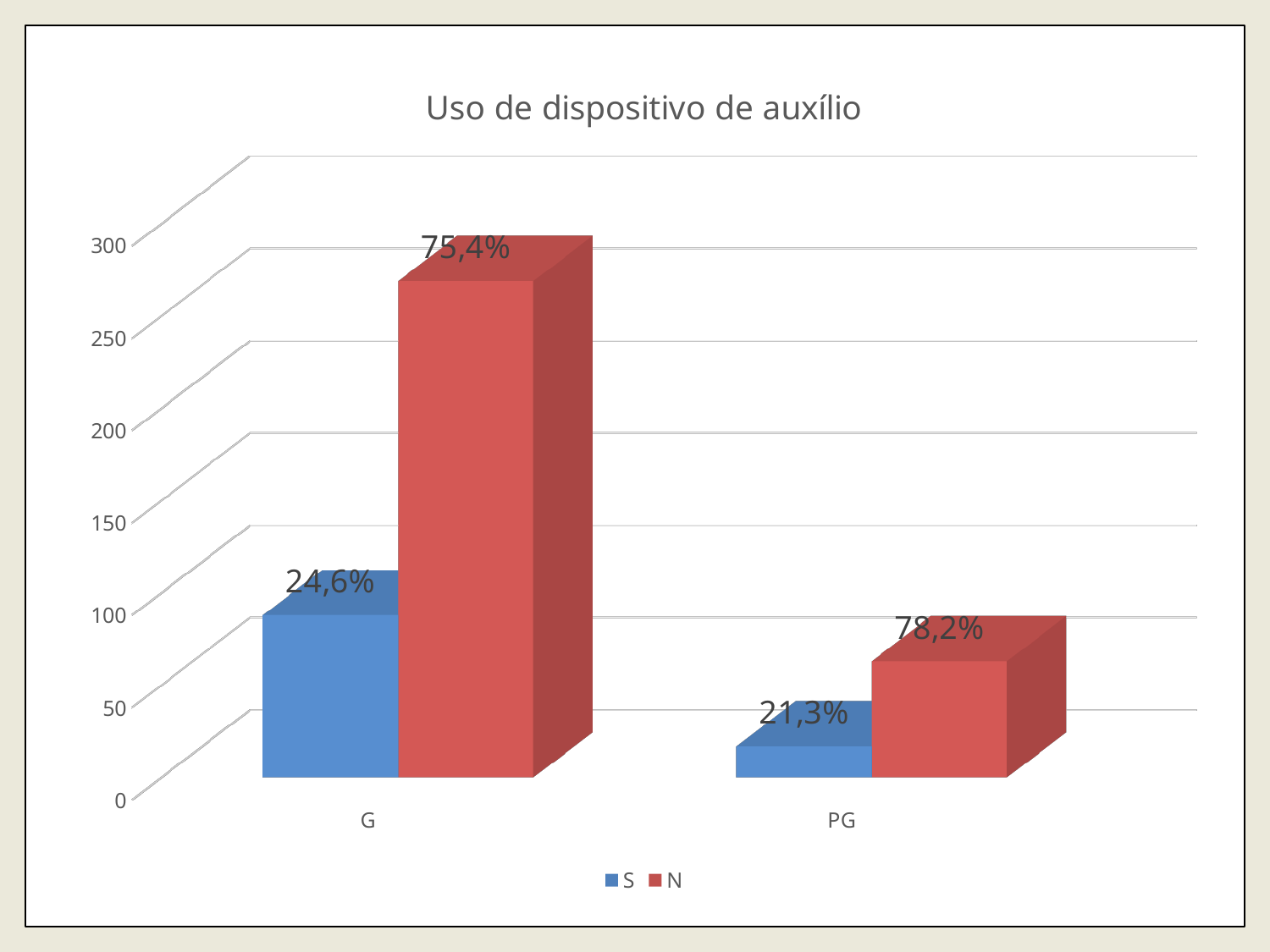
How many categories are shown on the x axis? 2 For category G, which series has the taller bar, S or N? N What is the data label shown on the N bar for category PG? 78,2% What is the title of the chart? Uso de dispositivo de auxílio How many series does the legend list? 2 Which bar is the tallest in the chart? N for G Which bar is the shortest in the chart? S for PG Is the N bar for category G greater or less than 200 on the axis? greater What is the data label shown on the N bar for category G? 75,4% What is the data label shown on the S bar for category PG? 21,3% Is the N bar for category PG greater or less than 100 on the axis? less What is the data label shown on the S bar for category G? 24,6%